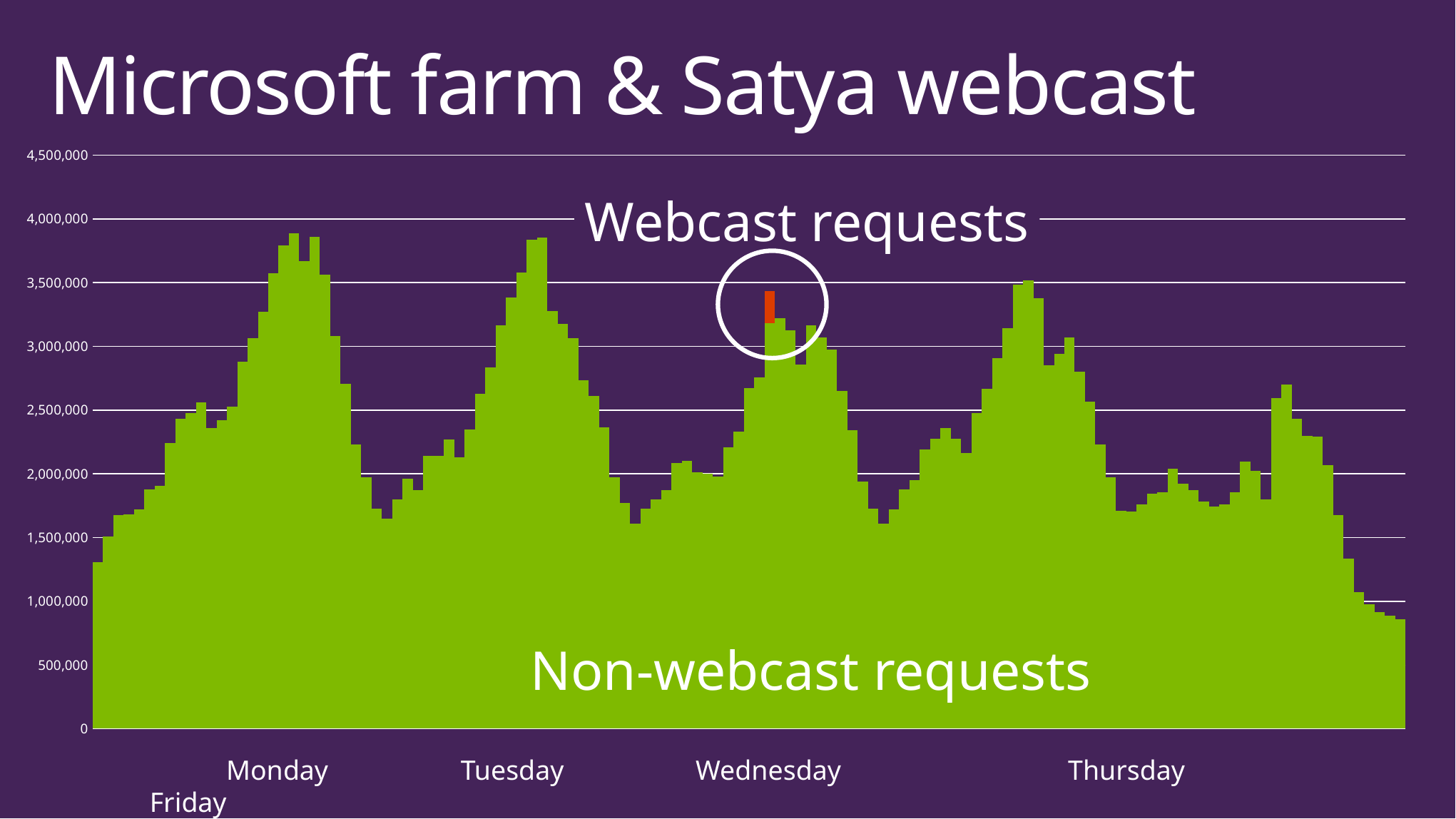
What is the title of the chart on the slide? Microsoft farm & Satya webcast How many series are labelled on the chart? 2 Do the values rise or fall from the Thursday peak to the right end of the chart? fall What is the highest value shown on the y axis? 4,500,000 Is the peak value on Monday greater or less than 3,500,000? greater Is the last bar at the right end of the chart greater or less than 1,000,000? less What are the two series labelled on the chart? Webcast requests and Non-webcast requests On which day do the Webcast requests appear in the chart? Wednesday Is the peak value on Wednesday (including webcast requests) greater or less than 3,500,000? less What kind of chart is shown on the slide? Stacked bar chart Which is larger, the peak on Monday or the peak on Wednesday? Monday How many day labels appear on the x axis? 5